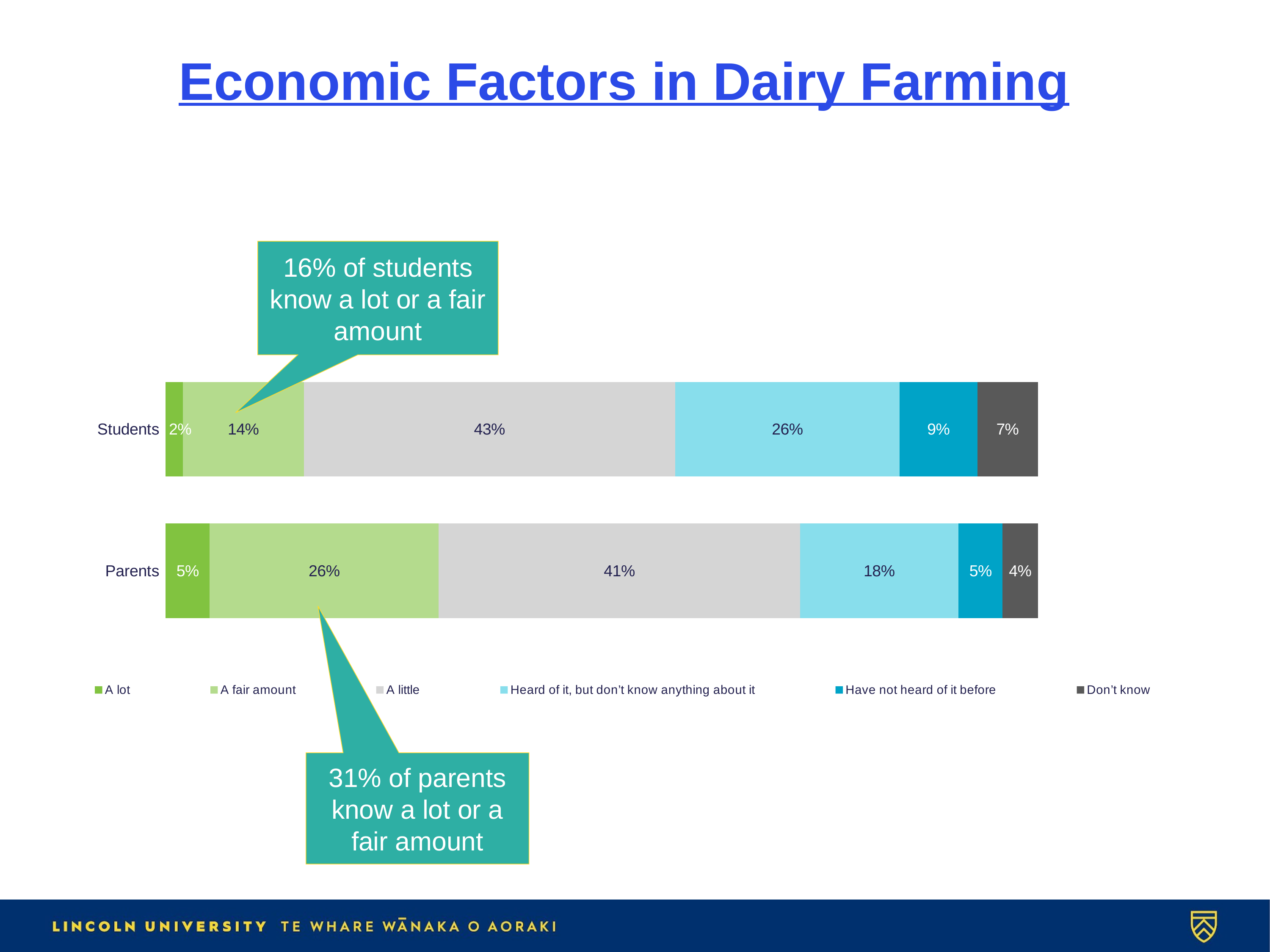
What percentage of Students answered 'A little'? 43% What is the difference between the 'Heard of it, but don't know anything about it' shares for Students and Parents? 8% Which response category has the largest share for Parents? A little Which response category has the smallest share for Students? A lot What is the combined share of Students who answered 'A lot' or 'A fair amount'? 16% How many groups (bars) are shown in the chart? 2 What percentage of Students answered 'Have not heard of it before'? 9% How many series does the legend list? 6 What percentage of Parents answered 'A fair amount'? 26% Which group has a larger share for 'A lot', Students or Parents? Parents What kind of chart is shown on the slide? Stacked bar chart What percentage of Parents answered 'Don't know'? 4%